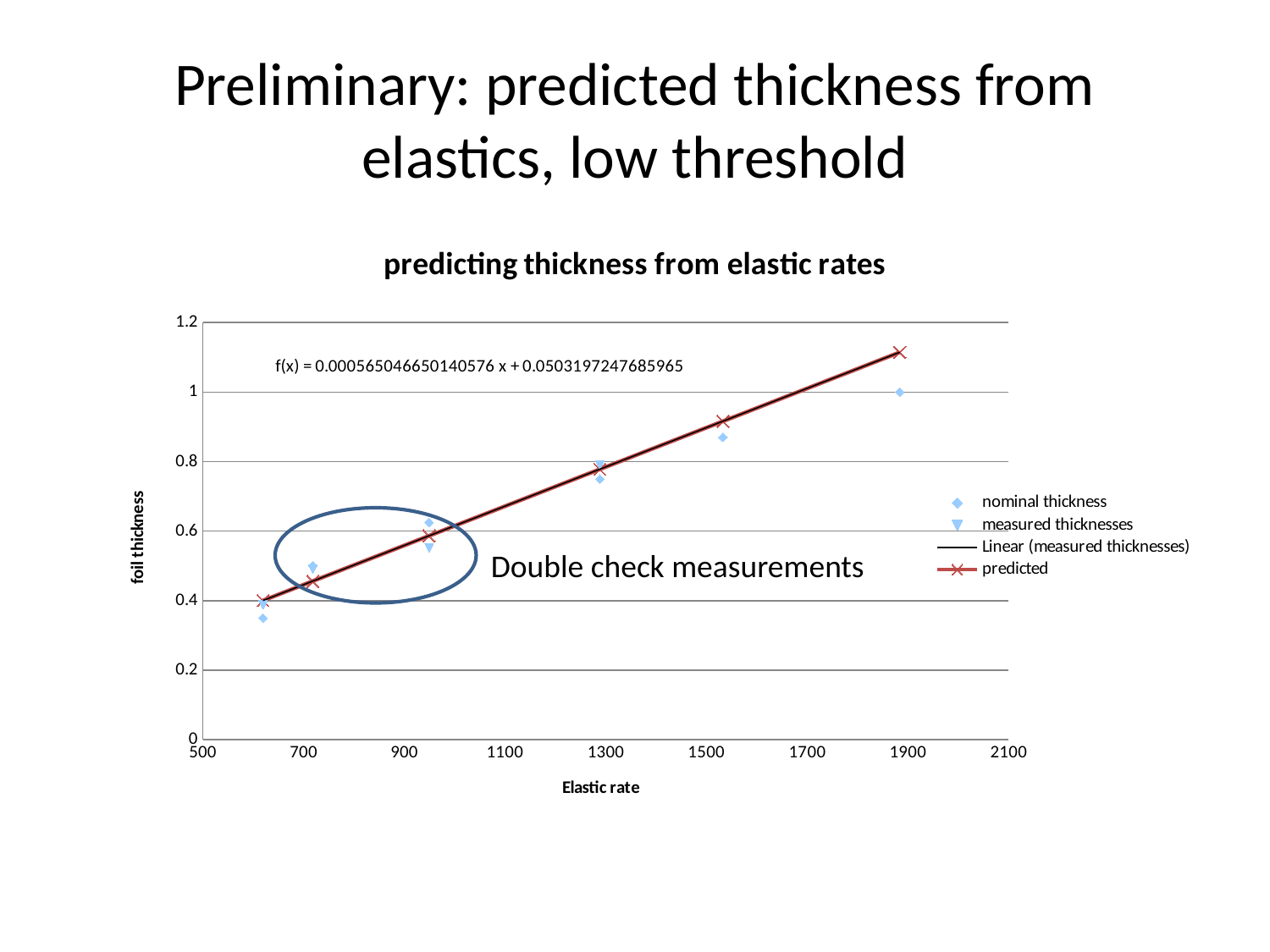
Do the predicted values rise or fall as the elastic rate increases? rise Is the nominal thickness at the lowest elastic rate (around 620) greater or less than 0.4? less How many series does the legend list? 4 Is the measured thickness at an elastic rate of about 950 greater or less than 0.6? less What is the title of the chart? predicting thickness from elastic rates What kind of chart is shown on the slide? scatter chart Is the predicted value at the highest elastic rate (around 1900) greater or less than 1? greater What is the label of the x axis? Elastic rate At the highest elastic rate (around 1900), which is larger: the nominal thickness or the predicted value? predicted How many predicted points are plotted? 6